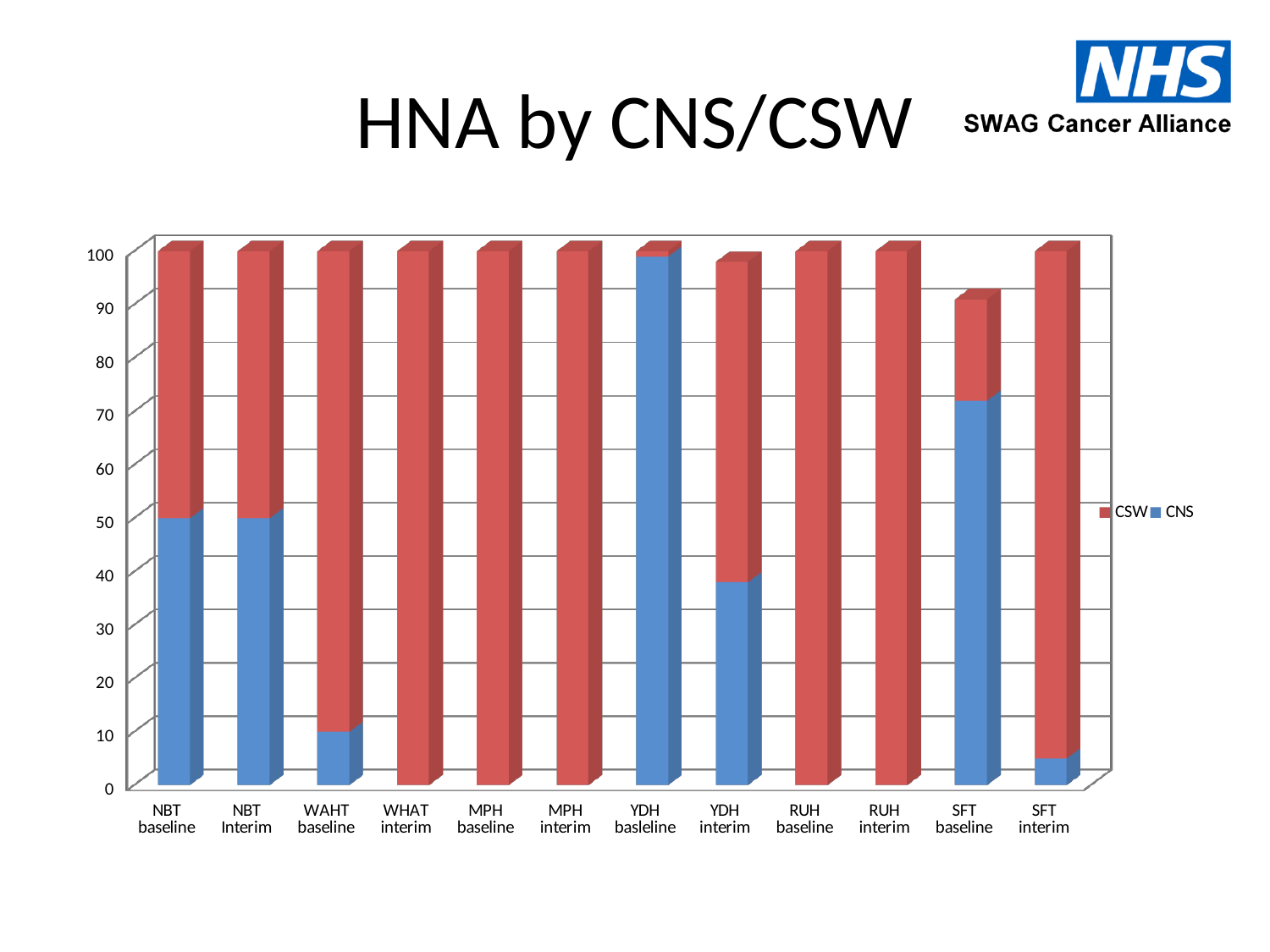
Is the CNS value for SFT baseline greater or less than 60? greater Is the CNS value for YDH interim greater or less than 30? greater What is the title of the chart on the slide? HNA by CNS/CSW How many series does the legend list? 2 How many categories are shown along the x axis? 12 Which category has the highest CNS value? YDH basleline Which category has the lowest CSW value? YDH basleline Which colour represents the CNS series? Blue What kind of chart is shown on the slide? Stacked bar chart Which has the larger CNS value, SFT baseline or YDH interim? SFT baseline Is the CNS value for YDH baseline greater or less than 90? greater